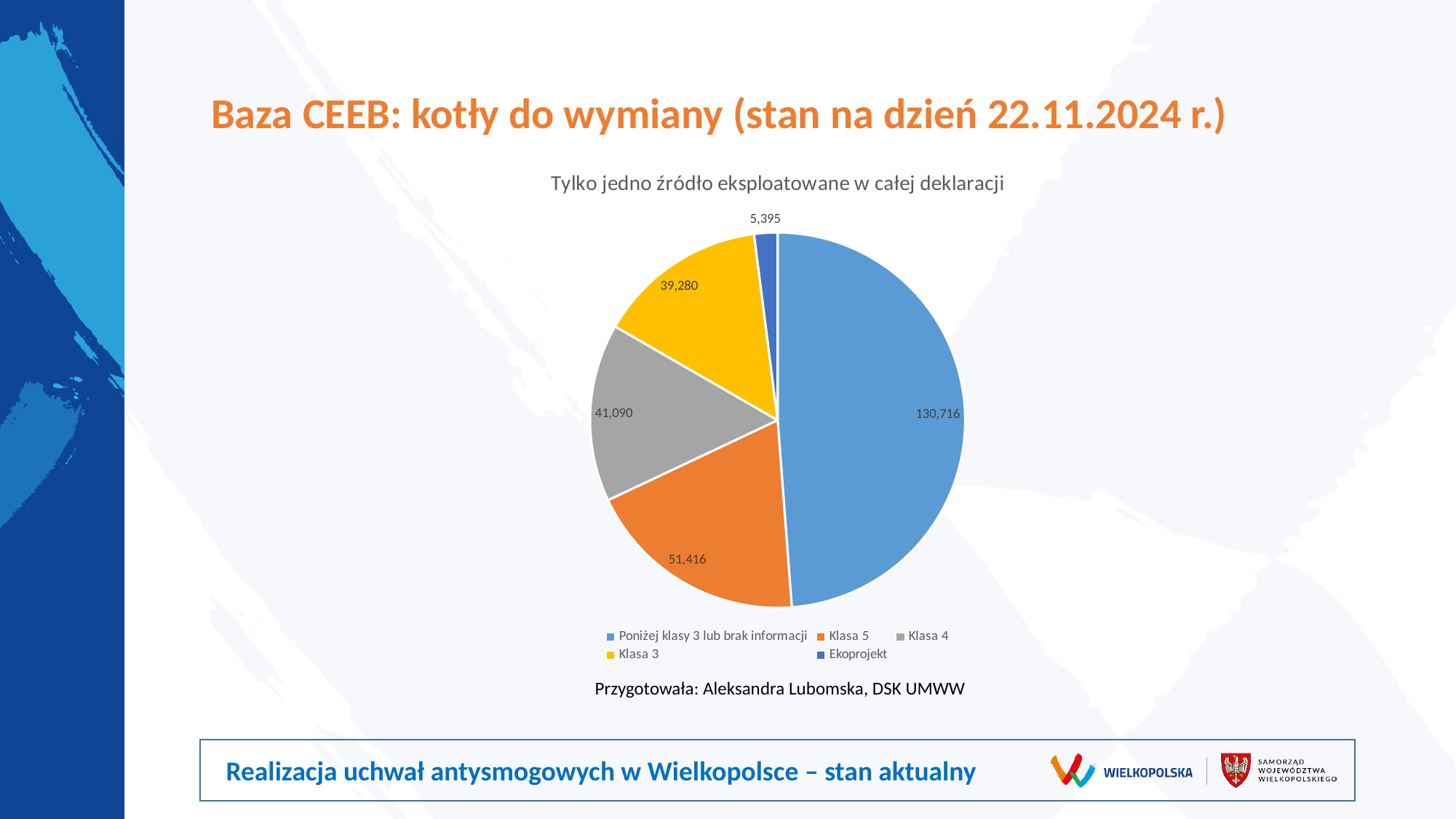
What kind of chart is shown on the slide? Pie chart What is the value for Ekoprojekt? 5,395 Which category has the largest slice of the pie? Poniżej klasy 3 lub brak informacji Which is larger, the value for Klasa 4 or the value for Klasa 3? Klasa 4 What is the total of all slices in the pie chart? 267,897 What is the difference between the values for 'Poniżej klasy 3 lub brak informacji' and Klasa 5? 79,300 What is the title of the pie chart? Tylko jedno źródło eksploatowane w całej deklaracji What is the value for Klasa 4? 41,090 What is the value for Klasa 5? 51,416 Which category has the smallest slice of the pie? Ekoprojekt How many slices does the pie chart have? 5 What is the value for the slice 'Poniżej klasy 3 lub brak informacji'? 130,716